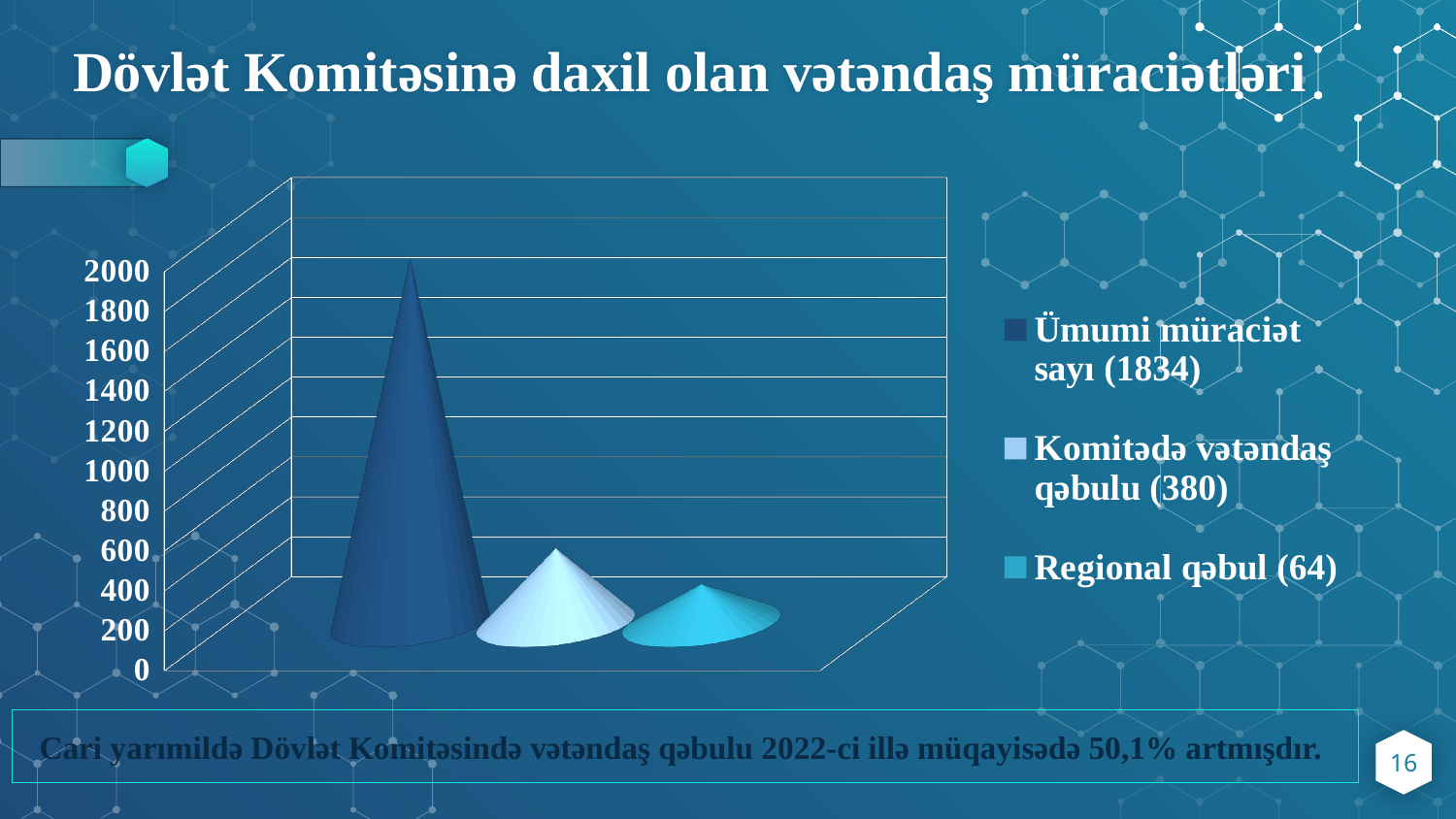
Is the value for Ümumi müraciət sayı greater or less than 1000? greater Which series has the lowest value? Regional qəbul What is the value for Komitədə vətəndaş qəbulu? 380 How many series does the legend list? 3 What is the value for Regional qəbul? 64 What kind of chart is shown on the slide? bar chart Which is larger, Komitədə vətəndaş qəbulu or Regional qəbul? Komitədə vətəndaş qəbulu What is the highest value shown on the vertical axis? 2000 What is the value for Ümumi müraciət sayı? 1834 What is the difference between Komitədə vətəndaş qəbulu and Regional qəbul? 316 Which series has the highest value? Ümumi müraciət sayı What is the difference between Ümumi müraciət sayı and Komitədə vətəndaş qəbulu? 1454